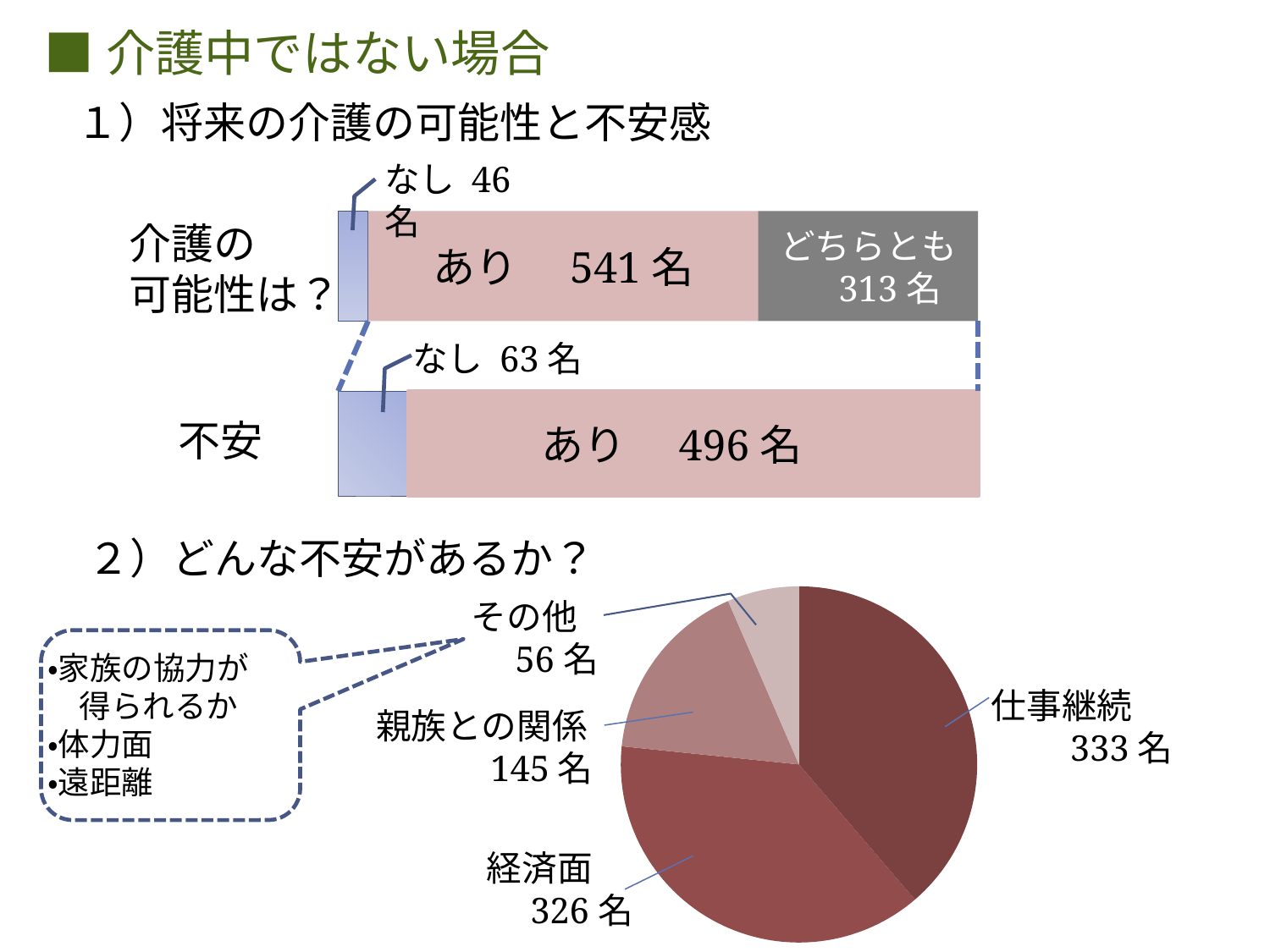
In the top chart (将来の介護の可能性と不安感), how many people answered なし for 不安? 63 名 In the pie chart (どんな不安があるか？), what is the difference between 仕事継続 and 親族との関係? 188 名 In the pie chart (どんな不安があるか？), which category has the smallest value? その他 In the pie chart (どんな不安があるか？), which category has the largest value? 仕事継続 In the top chart (将来の介護の可能性と不安感), how many people answered どちらとも for 介護の可能性は？? 313 名 In the pie chart (どんな不安があるか？), how many people chose 経済面? 326 名 What kind of chart is the top chart (将来の介護の可能性と不安感)? Stacked bar chart In the pie chart (どんな不安があるか？), how many categories are shown? 4 In the top chart (将来の介護の可能性と不安感), which answer has the smallest value for 介護の可能性は？? なし In the top chart (将来の介護の可能性と不安感), what is the difference between あり and なし for 不安? 433 名 In the top chart (将来の介護の可能性と不安感), how many people answered あり for 介護の可能性は？? 541 名 In the top chart (将来の介護の可能性と不安感), what is the total of the 介護の可能性は？ bar? 900 名